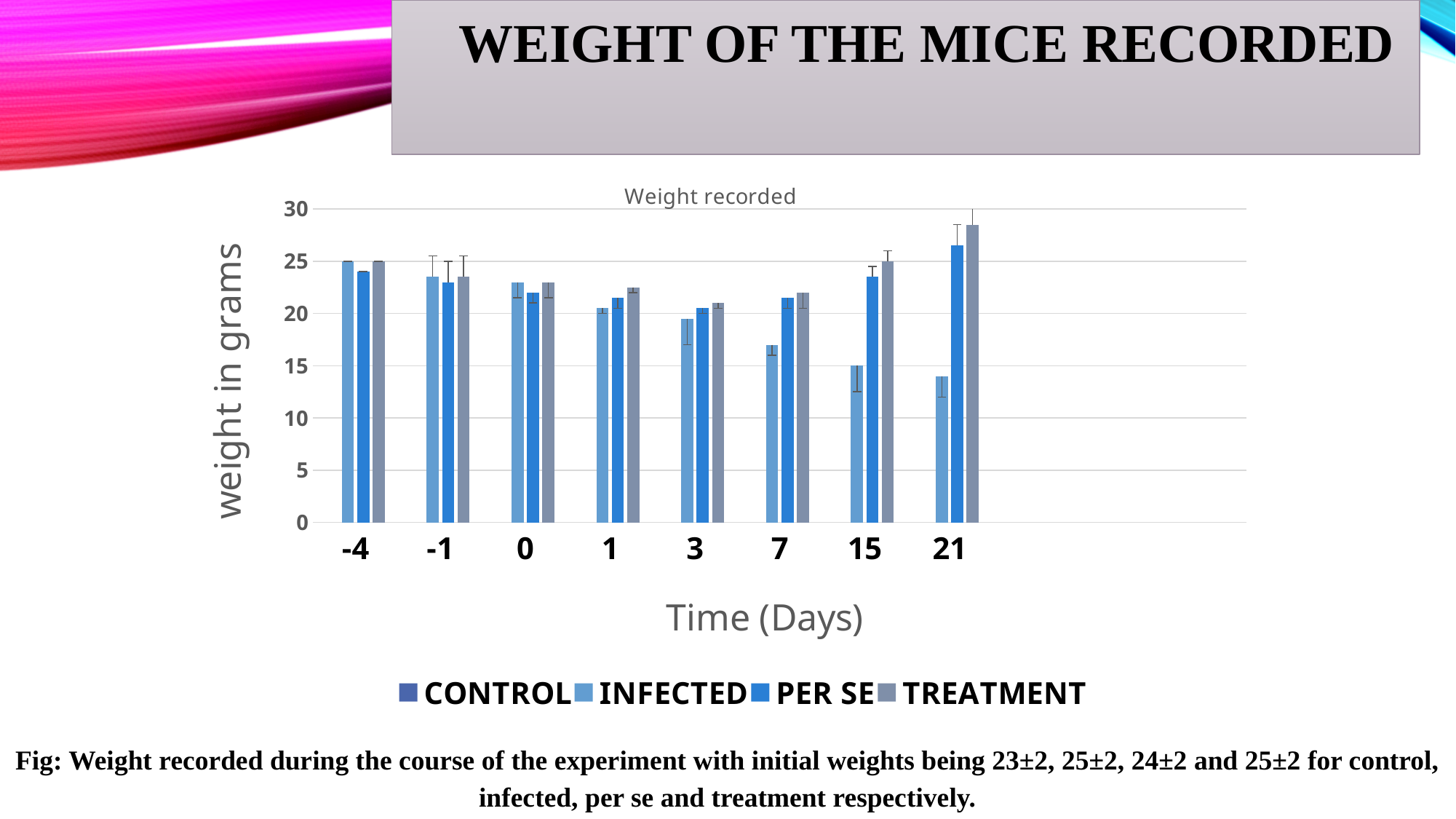
At which day does the TREATMENT series reach its highest value? 21 What is the label of the y axis of the chart? weight in grams What is the title of the chart? Weight recorded Is the value for TREATMENT at day 0 greater or less than 25? less What kind of chart is shown on the slide? bar chart Is the value for TREATMENT at day 21 greater or less than 25? greater Does the INFECTED series rise or fall from day -4 to day 21? fall Is the value for INFECTED at day 7 greater or less than 20? less How many series does the chart's legend list? 4 How many time points (days) are shown on the x axis of the chart? 8 At day 21, which series has the larger value, INFECTED or TREATMENT? TREATMENT